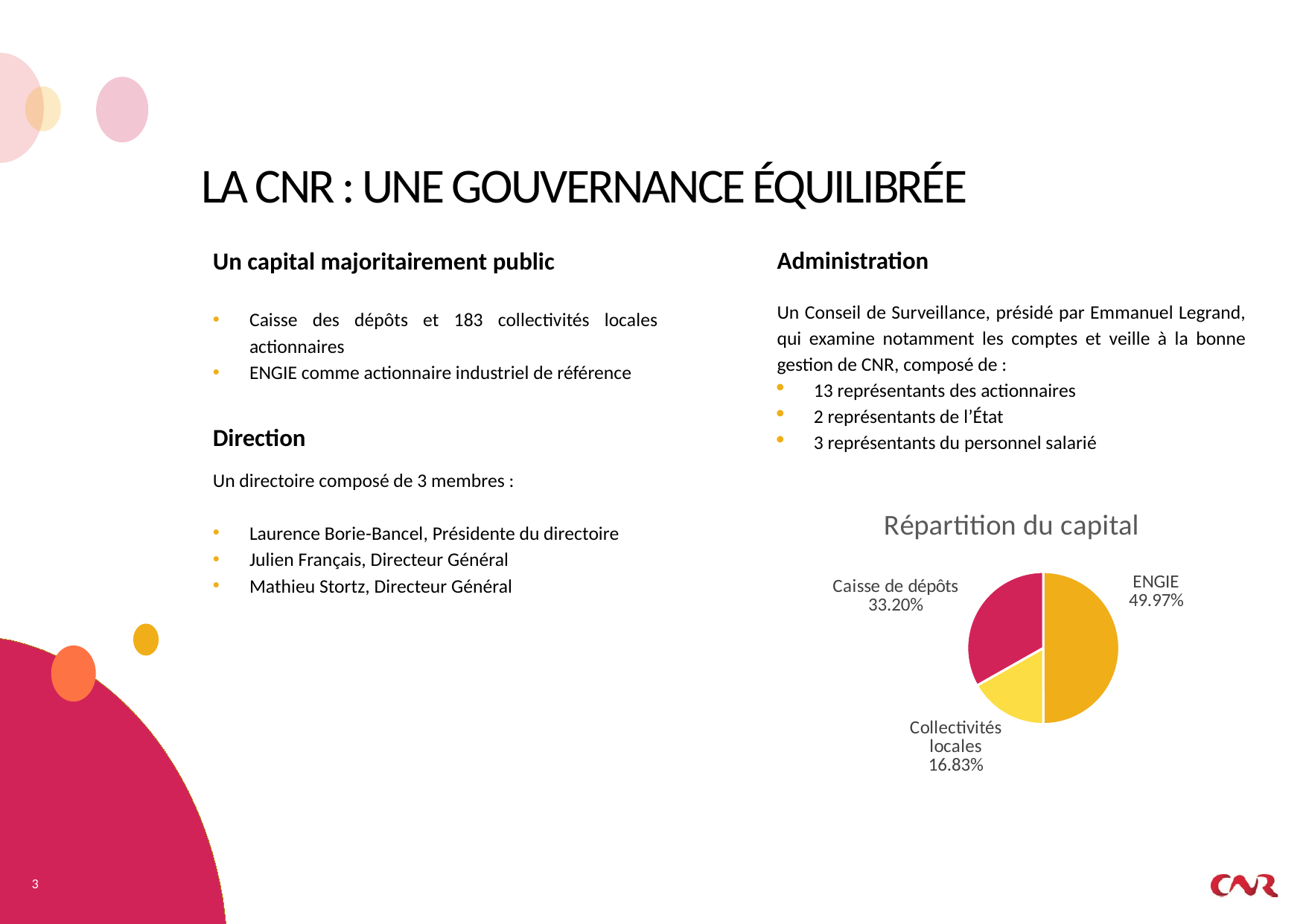
What colour is the ENGIE slice in the pie chart? orange What share of the capital do Collectivités locales hold according to the chart? 16.83% What share of the capital does Caisse de dépôts hold according to the chart? 33.20% What is the difference between the Caisse de dépôts share and the Collectivités locales share? 16.37% How many slices does the pie chart have? 3 What share of the capital does ENGIE hold according to the chart? 49.97% Which shareholder has the largest share of the capital? ENGIE What is the difference between the ENGIE share and the Caisse de dépôts share? 16.77% Which is larger, the share of Caisse de dépôts or the share of Collectivités locales? Caisse de dépôts What type of chart is shown on the slide? pie chart Which shareholder has the smallest share of the capital? Collectivités locales What is the title of the chart? Répartition du capital